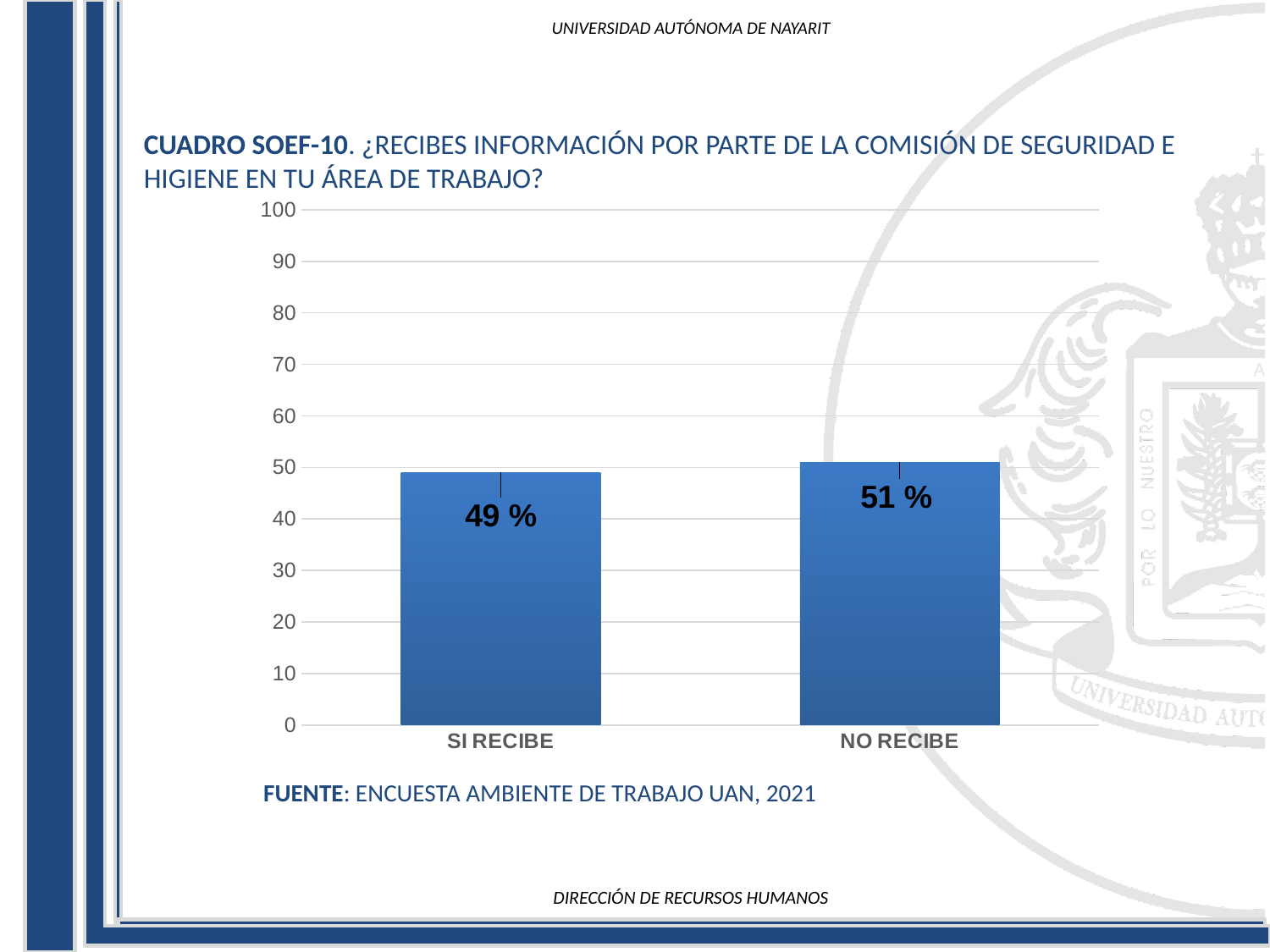
What is the maximum value shown on the y axis? 100 Is the value for SI RECIBE greater or less than 50? less Which is larger, the value for SI RECIBE or the value for NO RECIBE? NO RECIBE What kind of chart is shown on the slide? bar chart What is the value for SI RECIBE? 49 % Is the value for NO RECIBE greater or less than 60? less Which category has the highest value? NO RECIBE What is the difference between the values for NO RECIBE and SI RECIBE? 2 % How many categories are shown on the x axis? 2 Which category has the lowest value? SI RECIBE What is the total of the two bar values? 100 % What is the value for NO RECIBE? 51 %